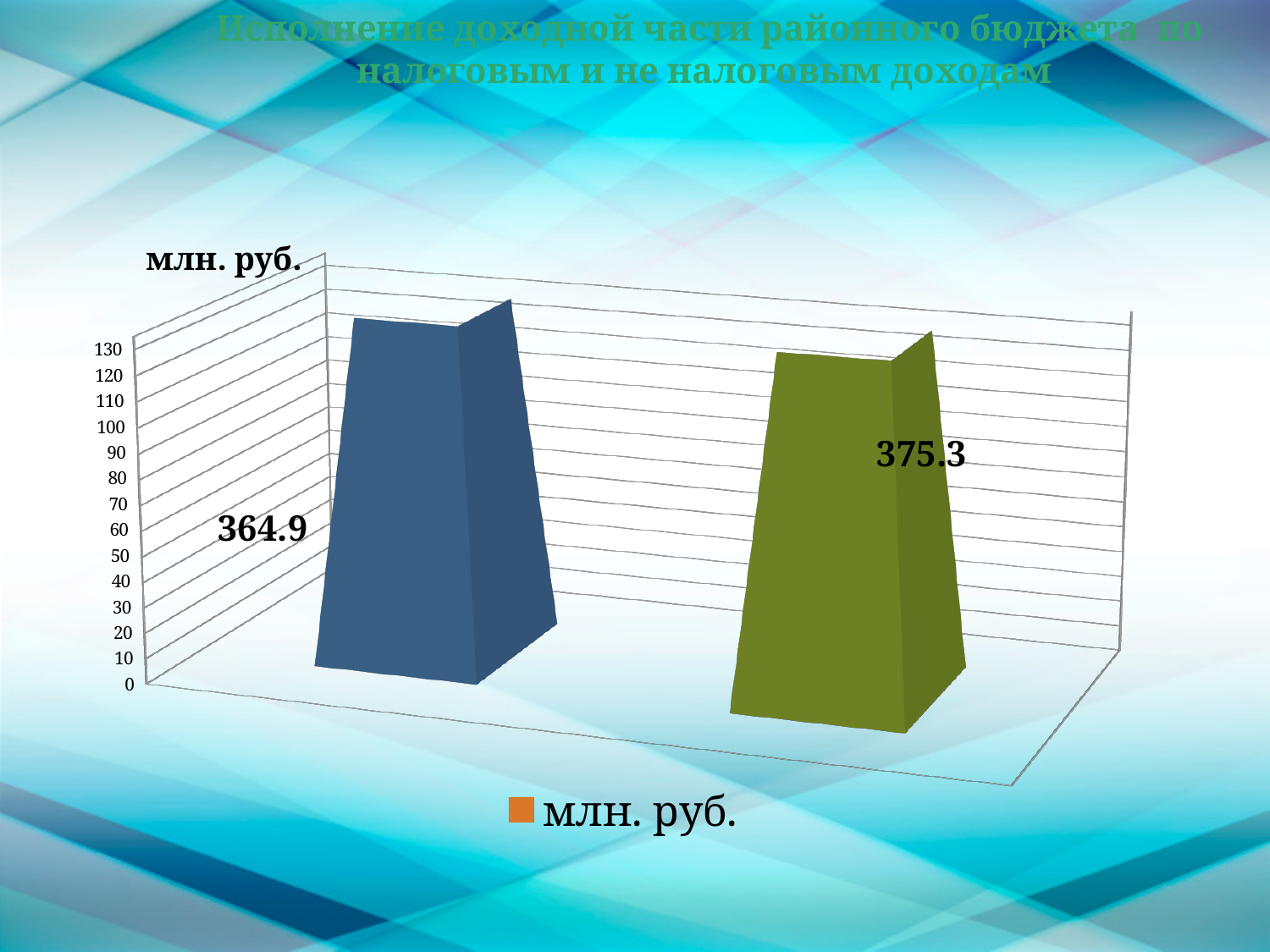
Which bar has the lower value, the blue bar on the left or the green bar on the right? the blue bar on the left Do the bar values rise or fall from left to right? rise What value is labelled on the blue bar on the left of the chart? 364.9 What kind of chart is shown on the slide? bar chart What is the highest tick value shown on the vertical axis? 130 How many series does the legend list? 1 What value is labelled on the green bar on the right of the chart? 375.3 What is the difference between the values of the green bar (375.3) and the blue bar (364.9)? 10.4 How many bars are plotted in the chart? 2 What is the legend entry shown below the chart? млн. руб. Is the value of the blue bar larger or smaller than the value of the green bar? smaller Which bar has the higher value, the blue bar on the left or the green bar on the right? the green bar on the right